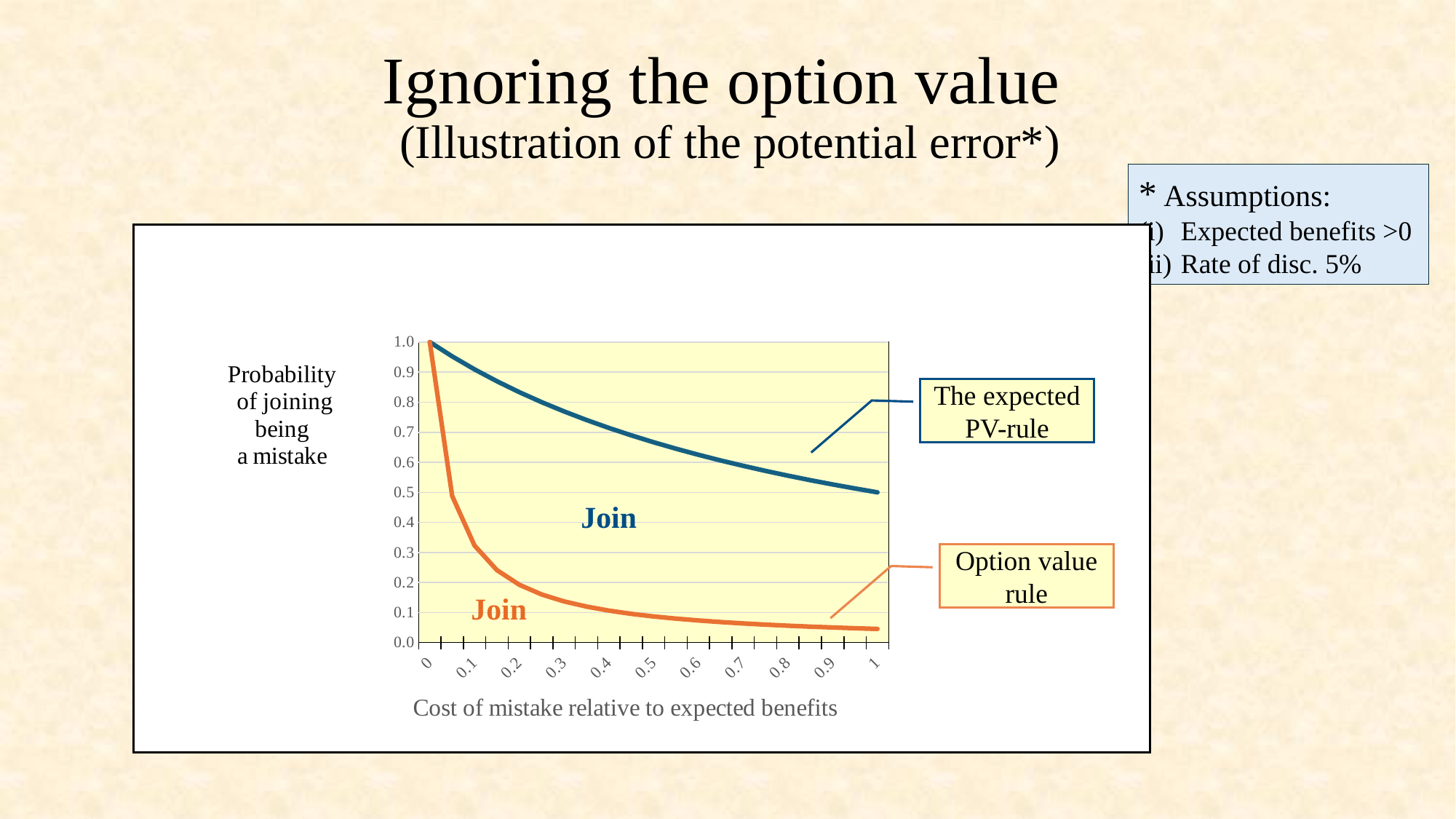
What is the label of the x axis? Cost of mistake relative to expected benefits What is the value of the expected PV-rule curve at a cost of mistake of 1? 0.5 Is the value of the Option value rule curve at a cost of mistake of 0.5 greater or less than 0.2? less At a cost of mistake of 0.3, which curve has the higher value, the expected PV-rule or the Option value rule? The expected PV-rule Is the value of the expected PV-rule curve at a cost of mistake of 0.5 greater or less than 0.6? greater Is the value of the Option value rule curve at a cost of mistake of 0.1 greater or less than 0.5? less Does the expected PV-rule curve rise or fall as the cost of mistake increases? fall Does the Option value rule curve rise or fall as the cost of mistake increases? fall What is the value of the expected PV-rule curve at a cost of mistake of 0? 1.0 What is the label of the y axis? Probability of joining being a mistake What kind of chart is shown on the slide? line chart How many curves are plotted on the chart? 2